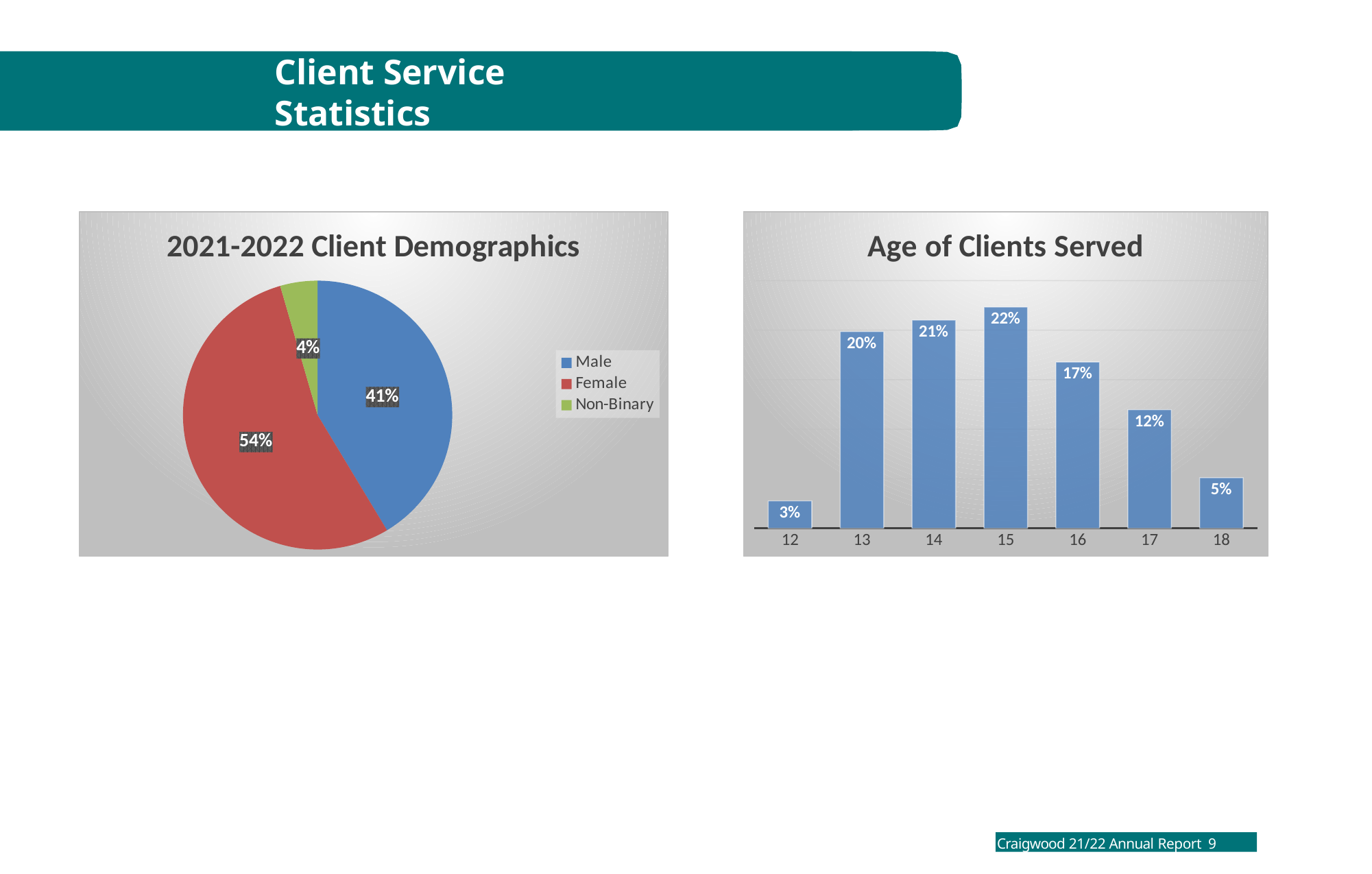
In the 'Age of Clients Served' chart, how many age categories are shown on the x axis? 7 In the 'Age of Clients Served' chart, what is the difference between the values for age 16 and age 17? 5% In the 'Age of Clients Served' chart, which age has the lowest value? 12 What kind of chart is the 'Age of Clients Served' chart? Bar chart In the '2021-2022 Client Demographics' chart, which category has the smallest slice? Non-Binary What kind of chart is the '2021-2022 Client Demographics' chart? Pie chart In the 'Age of Clients Served' chart, what is the value for age 18? 5% In the '2021-2022 Client Demographics' chart, how many categories does the legend list? 3 In the '2021-2022 Client Demographics' chart, what share of clients is Male? 41% In the '2021-2022 Client Demographics' chart, what share of clients is Female? 54% In the 'Age of Clients Served' chart, what is the value for age 15? 22% In the 'Age of Clients Served' chart, which age has the highest value? 15